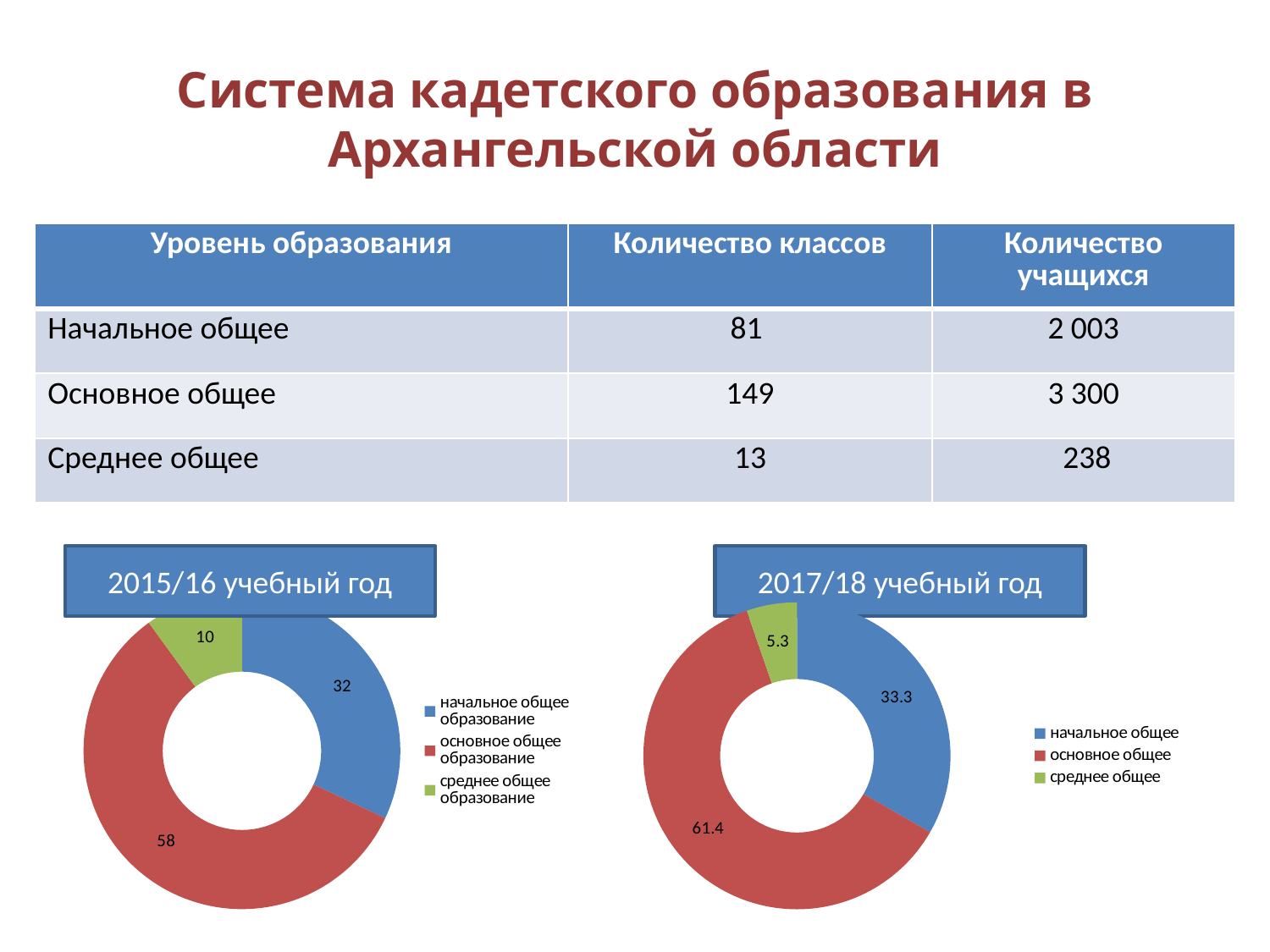
In the chart titled "2017/18 учебный год", what is the difference between the values for "основное общее" and "среднее общее"? 56.1 In the chart titled "2015/16 учебный год", which category has the largest slice? основное общее образование In the chart titled "2015/16 учебный год", what colour is the slice for "среднее общее образование"? green How many categories does the chart titled "2015/16 учебный год" show? 3 What kind of chart is the chart titled "2017/18 учебный год"? doughnut chart In the chart titled "2015/16 учебный год", what is the difference between the values for "основное общее образование" and "начальное общее образование"? 26 In the chart titled "2017/18 учебный год", which category has the smallest slice? среднее общее In the chart titled "2017/18 учебный год", what is the value for "среднее общее"? 5.3 In the chart titled "2015/16 учебный год", what is the value for "среднее общее образование"? 10 In the chart titled "2015/16 учебный год", what is the value for "основное общее образование"? 58 In the chart titled "2017/18 учебный год", which is larger: the value for "начальное общее" or the value for "основное общее"? основное общее In the chart titled "2017/18 учебный год", what is the value for "начальное общее"? 33.3